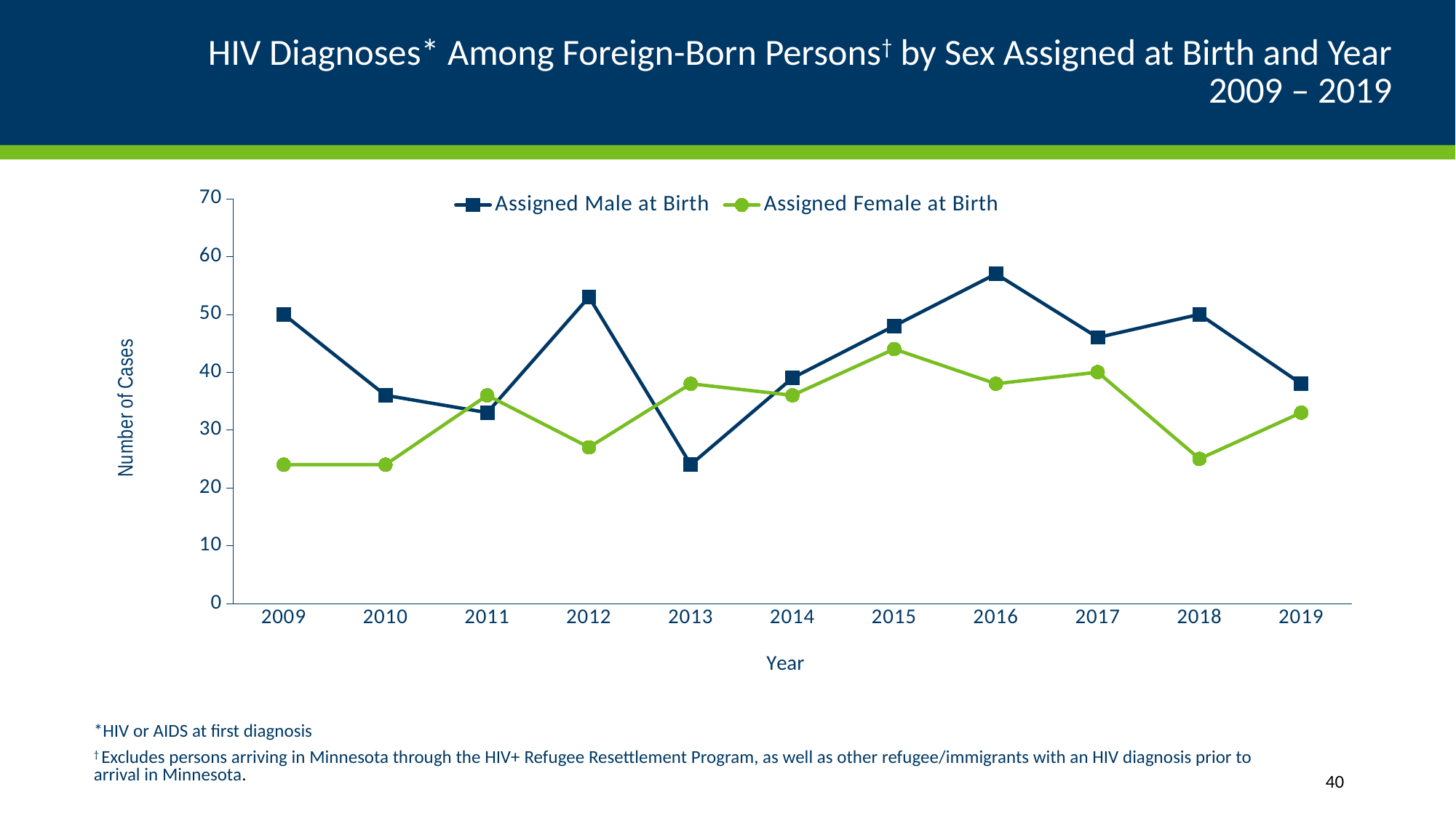
In which year is the Assigned Female at Birth series highest? 2015 Is the value for Assigned Female at Birth in 2018 greater or less than 30? less In 2009, which series has the larger value, Assigned Male at Birth or Assigned Female at Birth? Assigned Male at Birth What is the label on the y axis? Number of Cases What kind of chart is shown on the slide? line chart In which year is the Assigned Male at Birth series highest? 2016 How many years are plotted along the x axis? 11 Is the value for Assigned Male at Birth in 2013 greater or less than 30? less Is the value for Assigned Male at Birth in 2016 greater or less than 50? greater How many series does the legend list? 2 In 2013, which series has the larger value, Assigned Male at Birth or Assigned Female at Birth? Assigned Female at Birth In which year is the Assigned Male at Birth series lowest? 2013